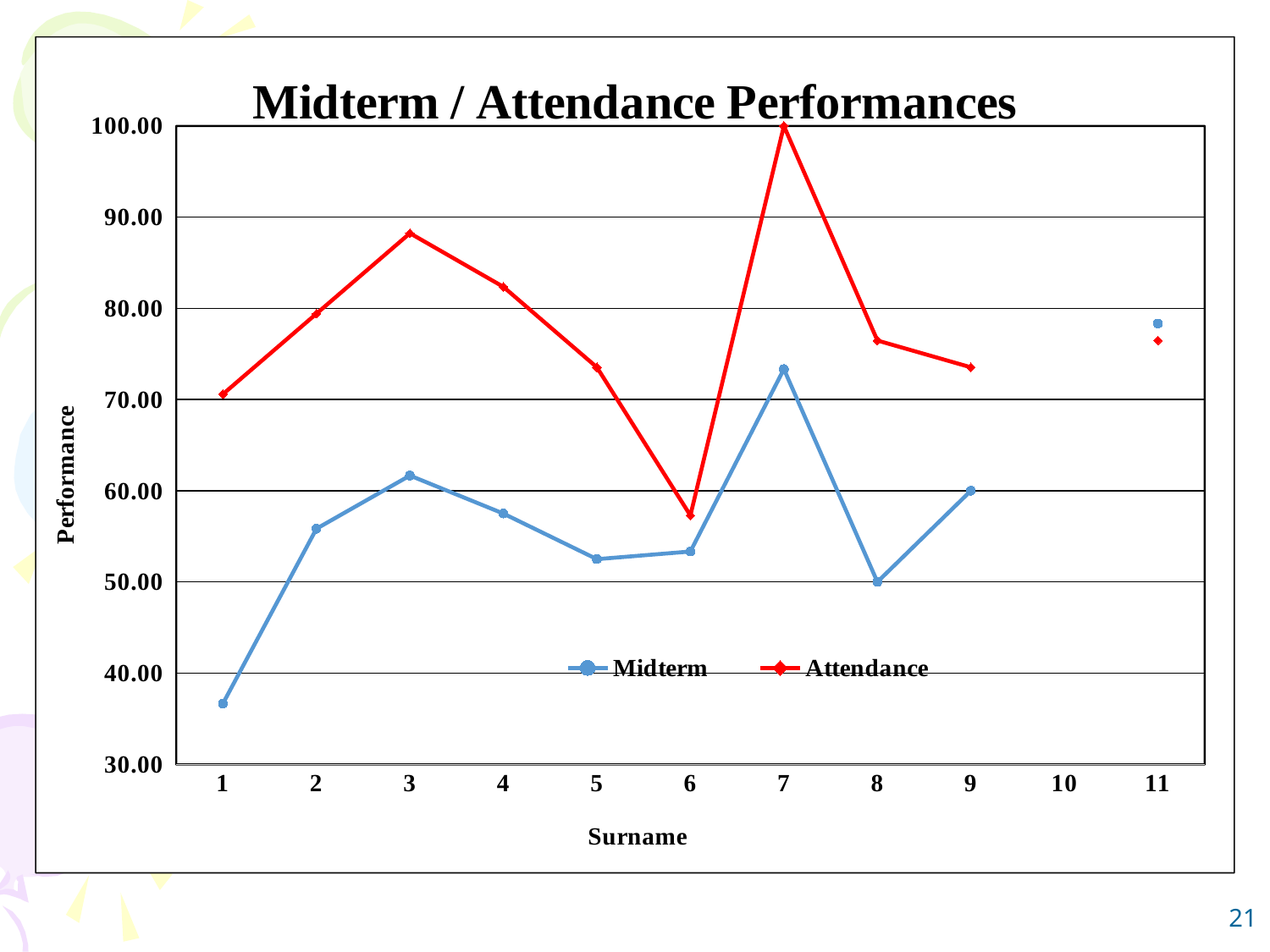
Is the Attendance value for surname number 3 greater or less than 80.00? greater For which surname number is the Midterm value lowest? 1 Is the Midterm value for surname number 1 greater or less than 40.00? less For which surname number is the Attendance value lowest? 6 What is the label of the x axis? Surname How many series does the legend list? 2 For which surname number is the Attendance value highest? 7 What kind of chart is shown on the slide? line chart What is the Attendance value for surname number 7? 100.00 For which surname number is the Midterm value highest? 11 For surname number 7, which series has the larger value, Midterm or Attendance? Attendance What is the title of the chart? Midterm / Attendance Performances